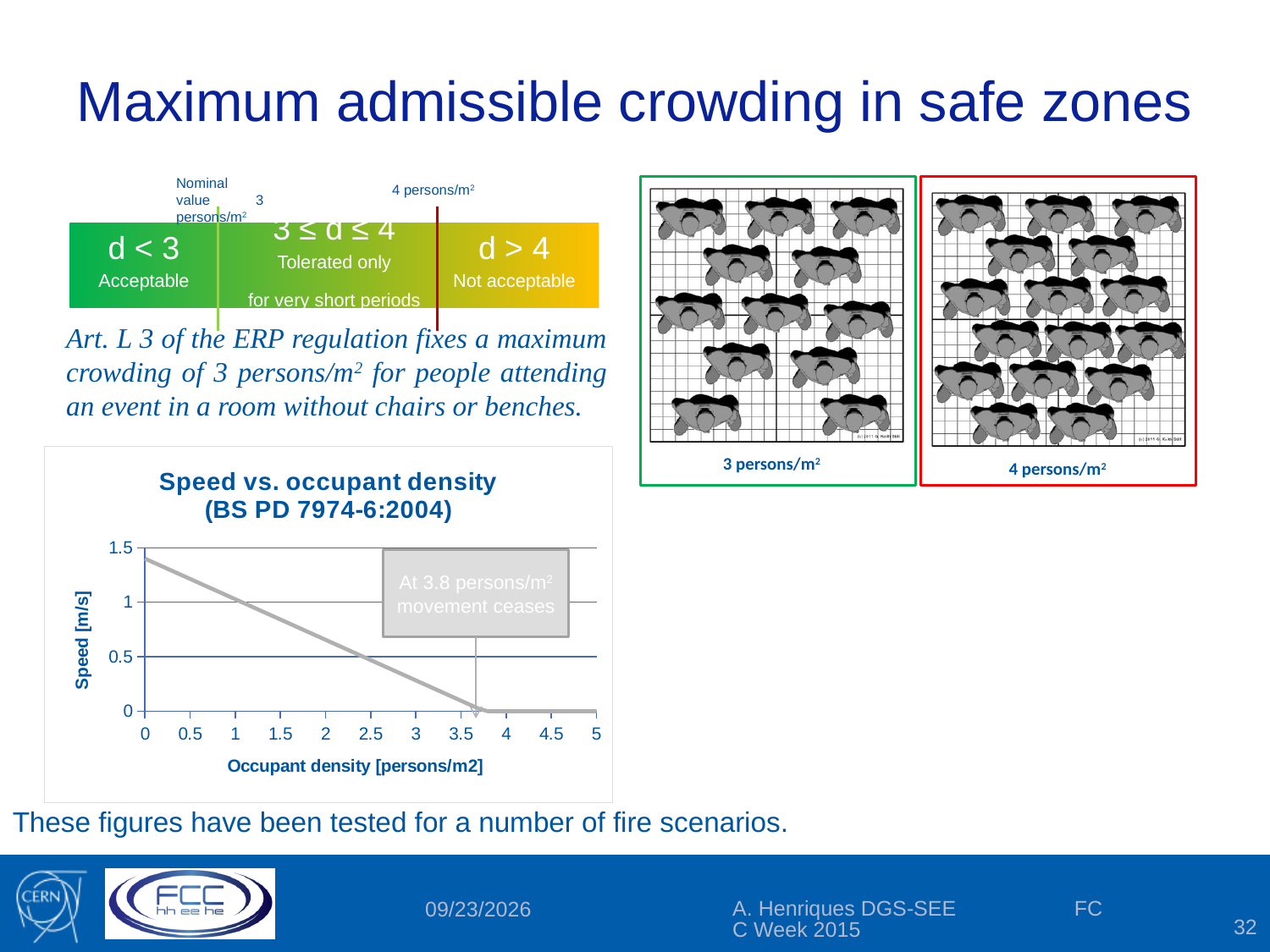
Does the speed rise or fall as occupant density increases from 0 to 3.5 persons/m2? fall What is the title of the chart? Speed vs. occupant density (BS PD 7974-6:2004) What is the speed at an occupant density of 5 persons/m2? 0 What is the label of the x axis of the chart? Occupant density [persons/m2] Which is larger, the speed at 1 person/m2 or the speed at 3 persons/m2? 1 person/m2 What kind of chart is shown on the slide? line chart Is the speed at an occupant density of 3 persons/m2 greater or less than 0.5 m/s? less Is the speed at an occupant density of 0 persons/m2 greater or less than 1 m/s? greater Is the speed at an occupant density of 2 persons/m2 greater or less than 0.5 m/s? greater At which occupant density is the speed highest? 0 According to the annotation on the chart, at what occupant density does movement cease? 3.8 persons/m2